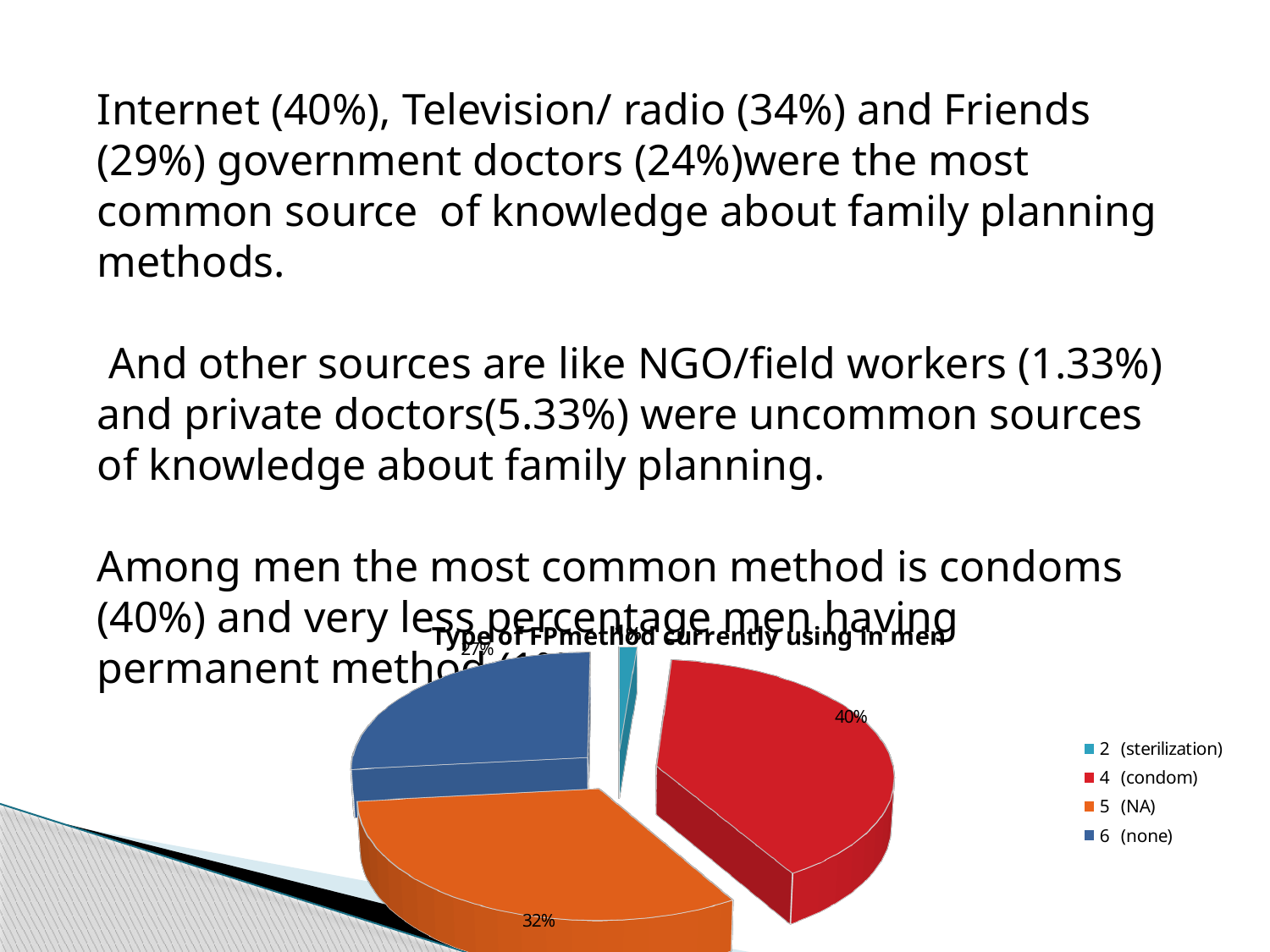
What percentage of men are shown as currently using condoms? 40% Which is larger in the pie chart, the condom share or the NA share? condom Is the share for the 'none' category greater or less than 30%? less What percentage is shown for the 'none' category in the pie chart? 27% What is the difference in percentage points between the condom share and the NA share? 8 What percentage is shown for the NA category in the pie chart? 32% Which category has the smallest share of the pie chart? 2 (sterilization) How many categories does the legend of the pie chart list? 4 What colour is the condom slice in the pie chart? red Which category has the largest share of the pie chart? 4 (condom) What kind of chart is shown on the slide? pie chart What is the title of the pie chart? Type of FPmethod currently using in men